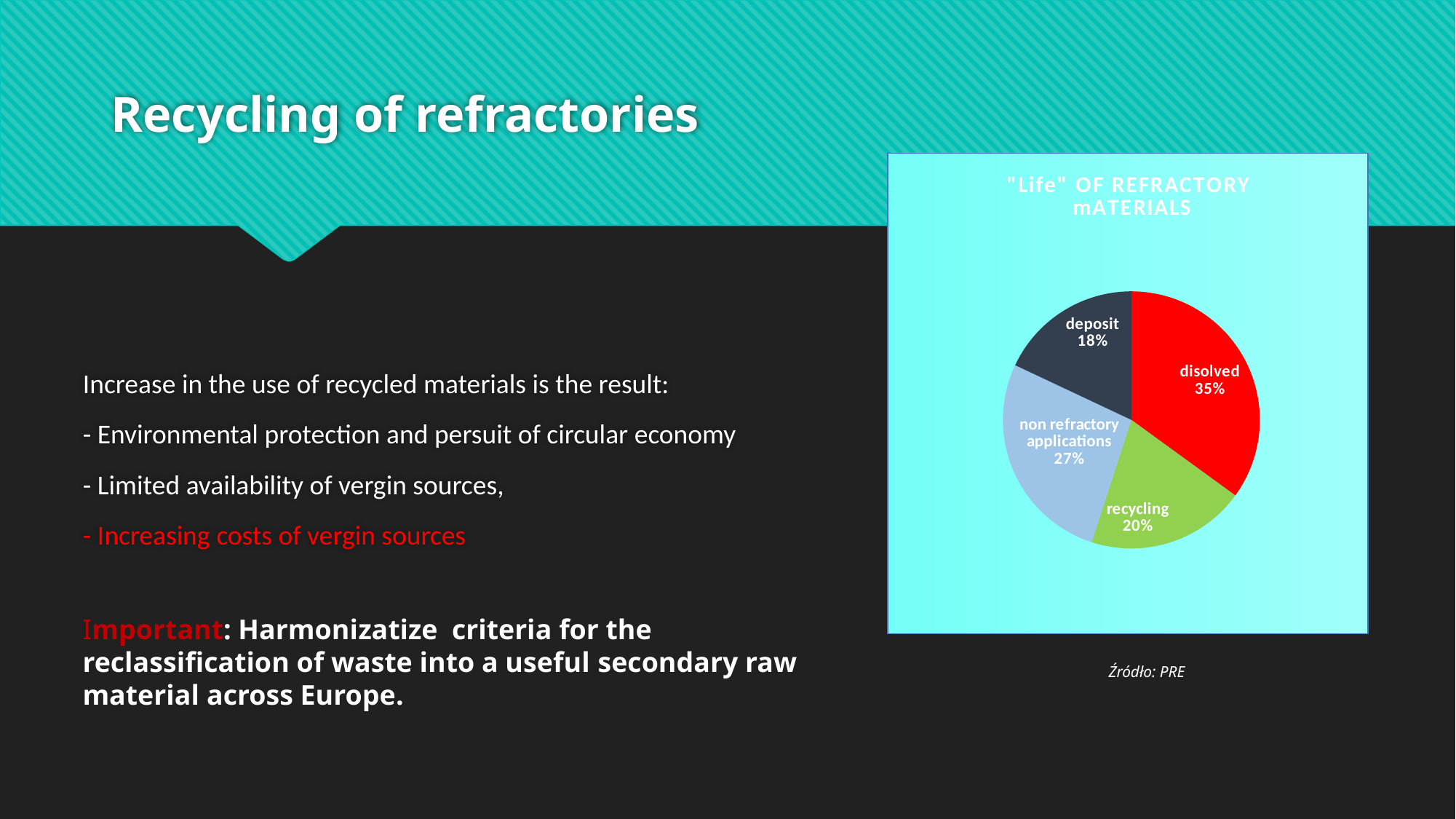
What share of the pie is labelled "deposit"? 18% Which slice of the pie is the smallest? deposit What kind of chart is shown on the slide? pie chart What colour is the "disolved" slice? red How many slices does the pie chart have? 4 Which slice of the pie is the largest? disolved What share of the pie is labelled "disolved"? 35% What is the title of the chart? "Life" OF REFRACTORY mATERIALS What is the difference in percentage points between the "disolved" and "recycling" slices? 15 What share of the pie is labelled "recycling"? 20% Which is larger, the "non refractory applications" slice or the "deposit" slice? non refractory applications